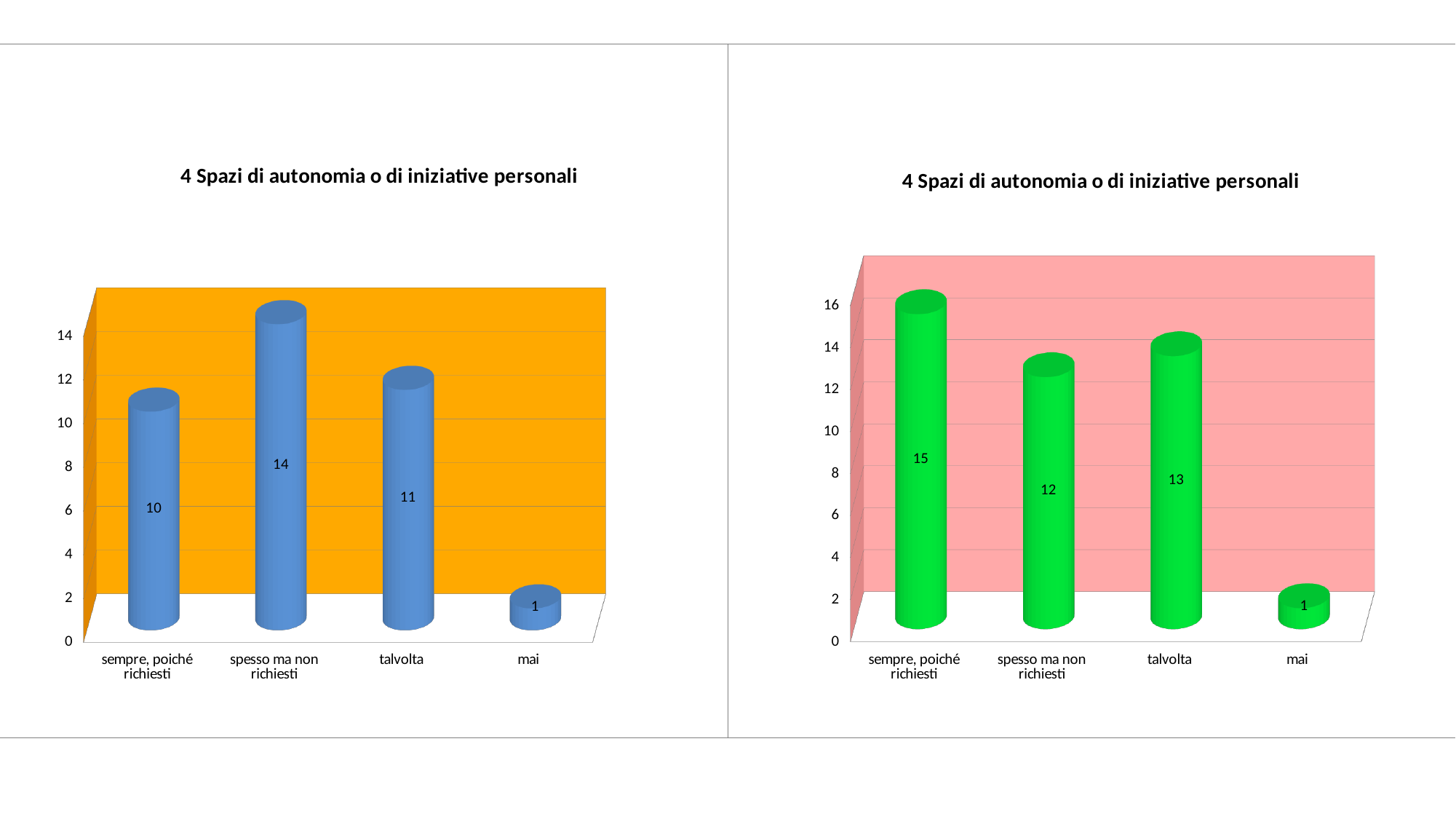
In the left chart, which category has the lowest value? mai In the right chart, what is the value for 'talvolta'? 13 In the left chart, which category has the highest value? spesso ma non richiesti In the right chart, what is the difference between 'sempre, poiché richiesti' and 'spesso ma non richiesti'? 3 In the right chart, which is larger: 'spesso ma non richiesti' or 'talvolta'? talvolta In the left chart, what is the value for 'spesso ma non richiesti'? 14 What is the title of the right chart? 4 Spazi di autonomia o di iniziative personali In the left chart, what is the difference between 'spesso ma non richiesti' and 'talvolta'? 3 What kind of chart is the left chart? bar chart In the right chart, which category has the highest value? sempre, poiché richiesti How many categories are shown in the right chart? 4 In the left chart, which is larger: 'sempre, poiché richiesti' or 'talvolta'? talvolta